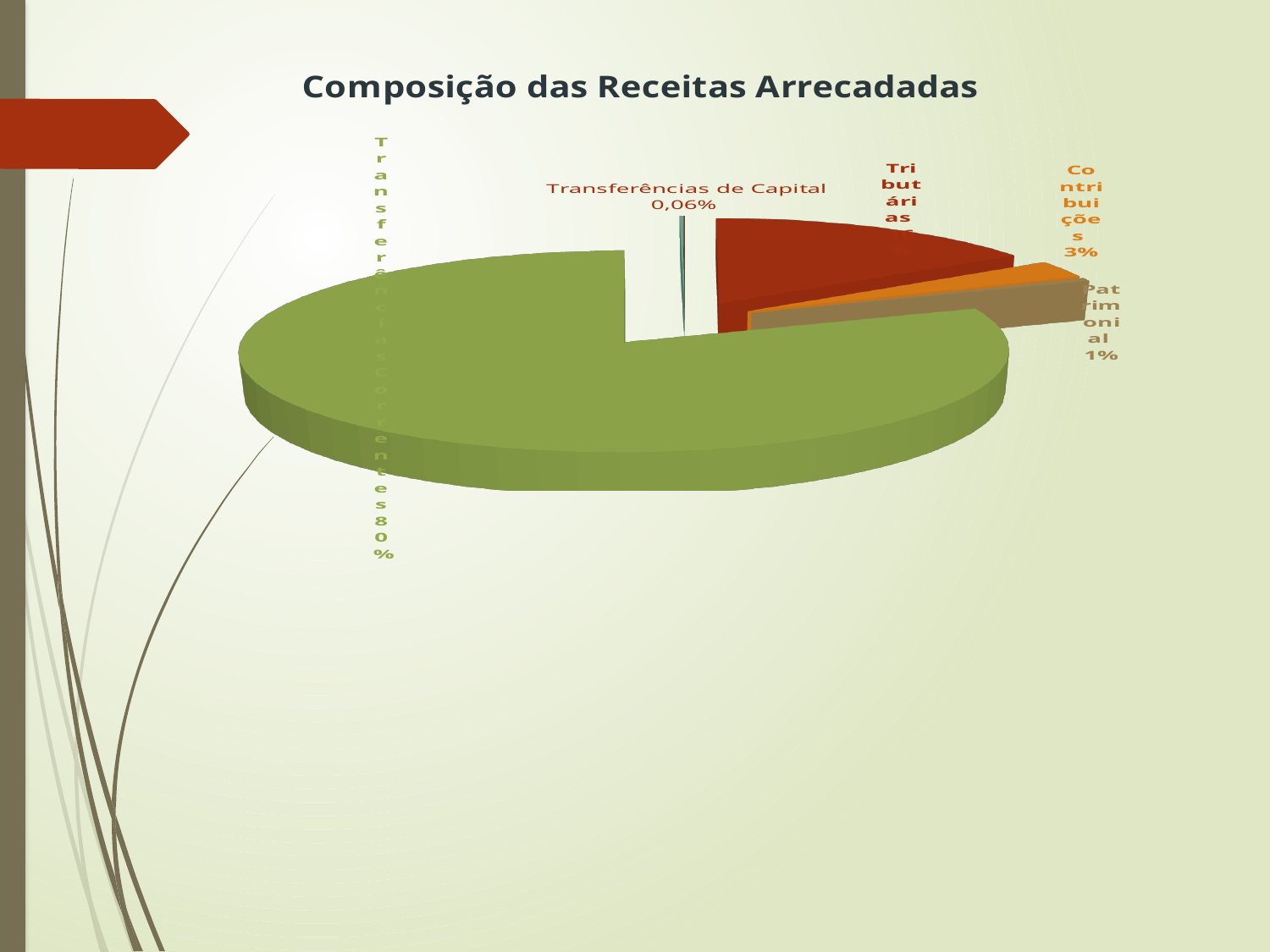
How many slices does the pie chart have? 6 Which is larger, the share for Contribuições or the share for Patrimonial? Contribuições What share of the pie does Transferências de Capital represent? 0,06% What share of the pie does Patrimonial represent? 1% What is the title of the chart? Composição das Receitas Arrecadadas What is the difference between the share for Contribuições and the share for Patrimonial? 2% Which category has the smallest slice of the pie? Transferências de Capital What colour is the Transferências Correntes slice? Green What kind of chart is shown on the slide? Pie chart Which category has the largest slice of the pie? Transferências Correntes What share of the pie does Transferências Correntes represent? 80% What share of the pie does Contribuições represent? 3%